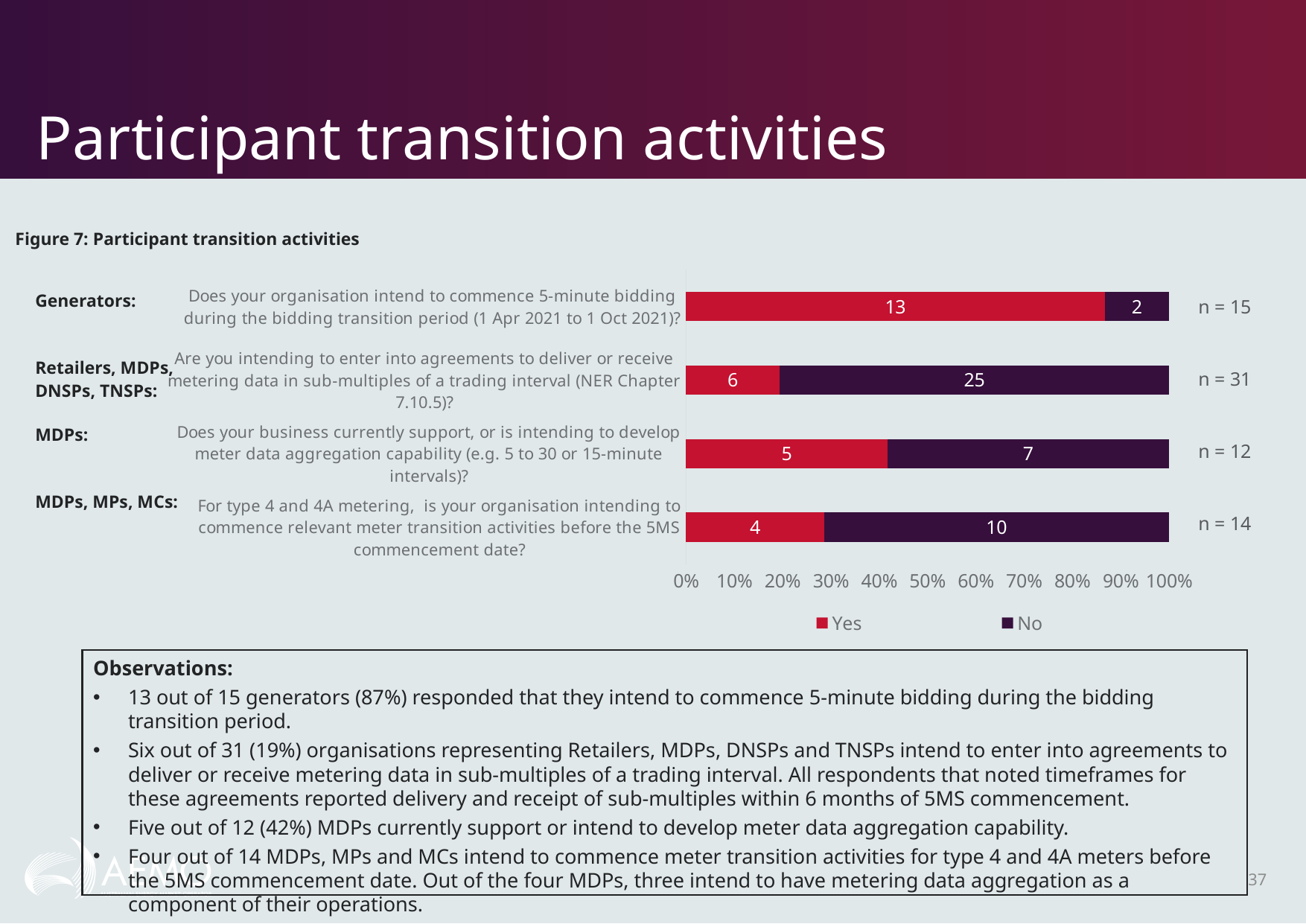
For MDPs, which response is larger, Yes or No? No Is the Yes share of the Generators bar greater or less than 80%? greater Which respondent group has the lowest number of Yes responses? MDPs, MPs, MCs How many Generators answered Yes to whether they intend to commence 5-minute bidding during the bidding transition period? 13 How many respondents in the MDPs, MPs, MCs group answered No? 10 Which respondent group has the highest number of Yes responses? Generators What is the difference between the Yes and No counts for Generators? 11 How many respondent groups (bars) are shown in the chart? 4 How many series does the legend list? 2 How many respondents in the Retailers, MDPs, DNSPs, TNSPs group answered No? 25 What is the total number of responses in the Retailers, MDPs, DNSPs, TNSPs bar? 31 How many MDPs answered Yes to currently supporting or intending to develop meter data aggregation capability? 5